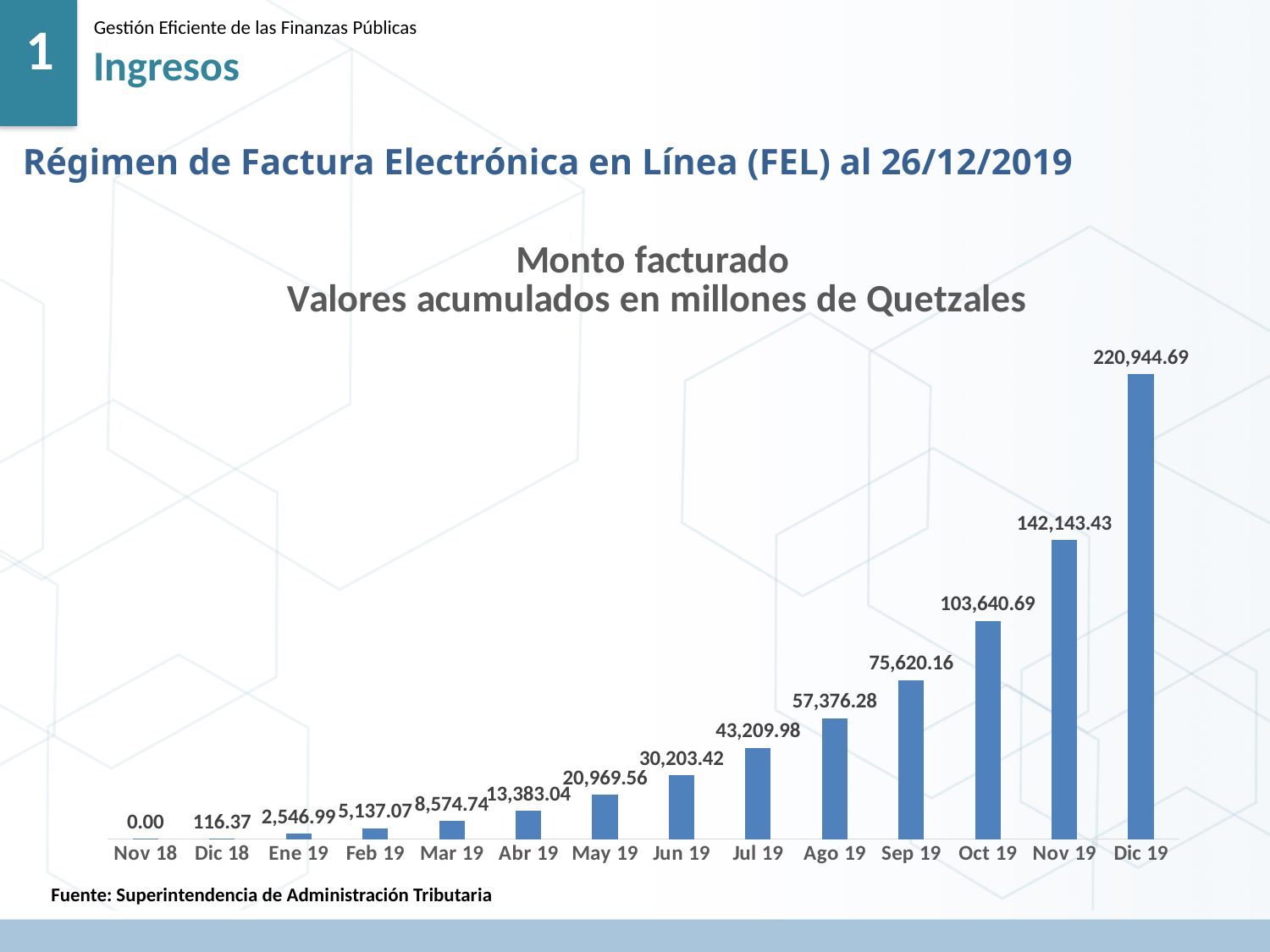
Which month has the lowest value? Nov 18 Which month has the highest value? Dic 19 What is the value for Dic 18? 116.37 What kind of chart is this? Bar chart What is the difference between the values for Dic 19 and Nov 19? 78,801.26 Do the values rise or fall from Nov 18 to Dic 19? Rise What is the value for Mar 19? 8,574.74 How many months are shown on the x axis? 14 What is the difference between the values for Oct 19 and Sep 19? 28,020.53 Which is larger, the value for Ago 19 or the value for Jun 19? Ago 19 What is the value for Dic 19? 220,944.69 What is the value for Jul 19? 43,209.98